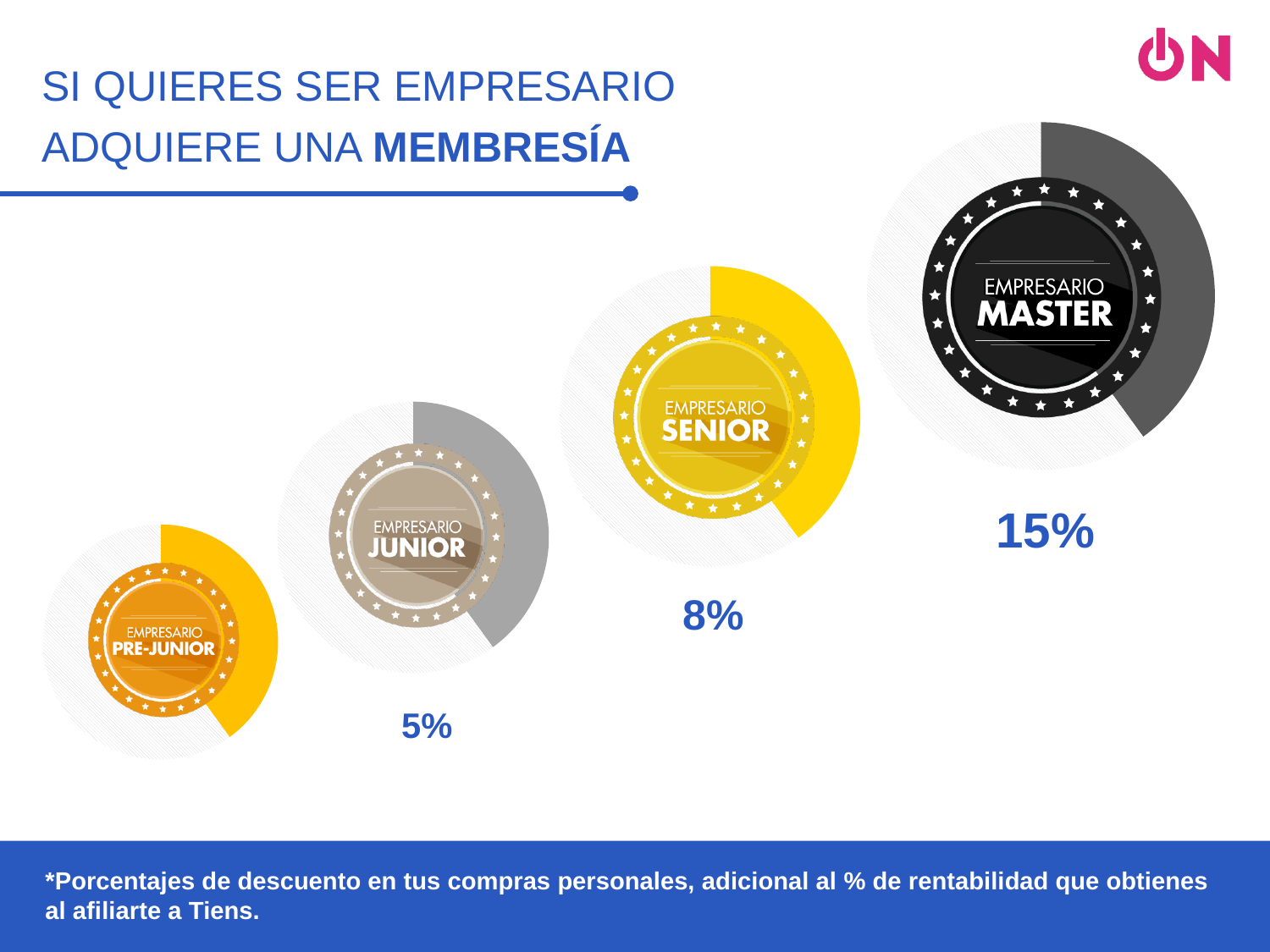
What discount percentage is shown for the Empresario Junior membership? 5% Which membership level has the highest discount percentage shown on the slide? Empresario Master Which has a larger percentage, Empresario Senior or Empresario Junior? Empresario Senior What is the difference between the Empresario Senior and Empresario Junior percentages? 3% Do the printed percentages rise or fall from left to right across the membership levels? Rise What kind of chart is used to display each membership level? Donut chart Of the membership levels with a printed percentage, which has the lowest? Empresario Junior Which membership level is shown with a black badge? Empresario Master What discount percentage is shown for the Empresario Senior membership? 8% How many membership levels are shown on the slide? 4 What discount percentage is shown for the Empresario Master membership? 15% What is the difference between the Empresario Master and Empresario Senior percentages? 7%